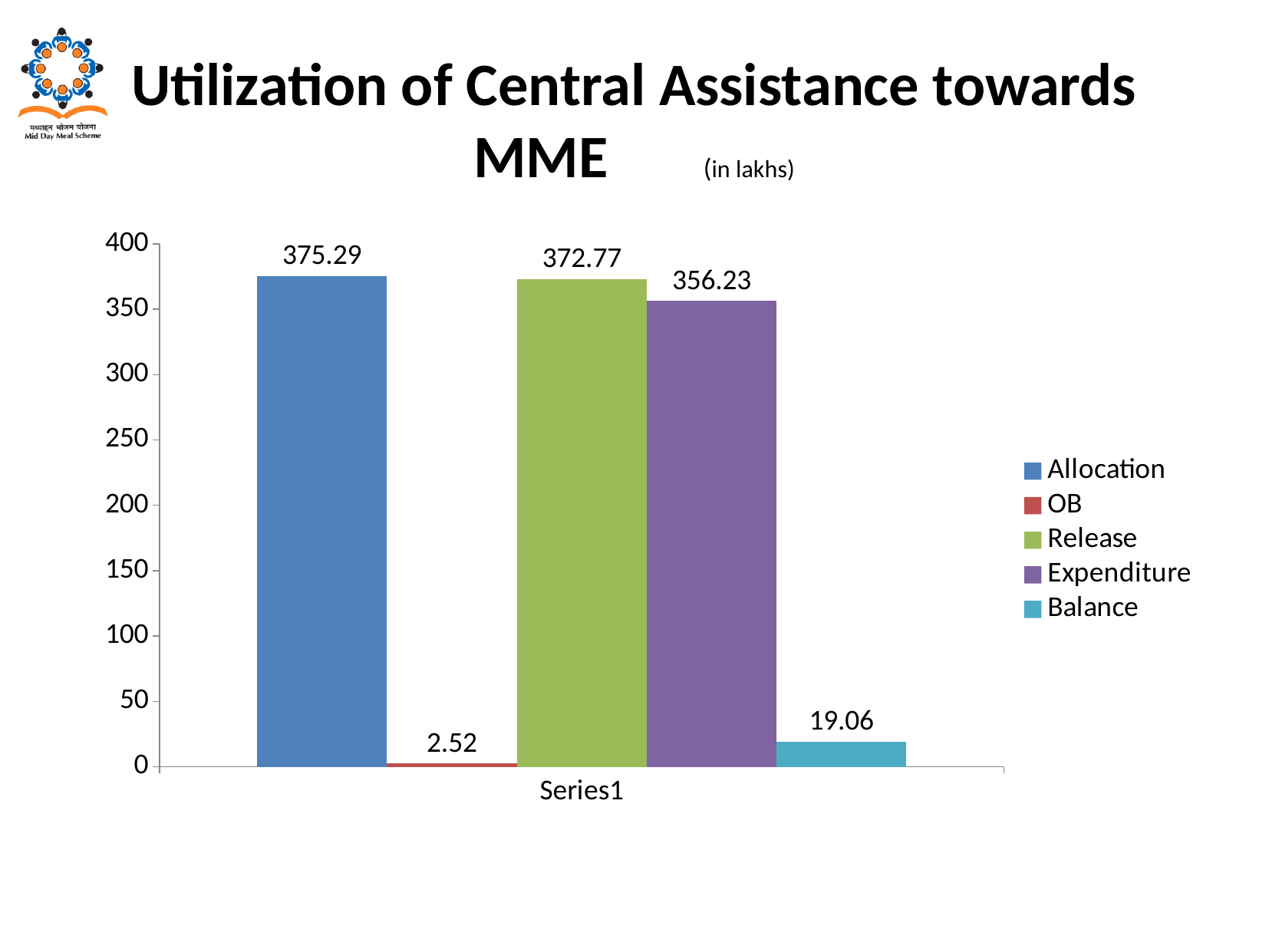
What is the difference between Release and Expenditure? 16.54 Is the value for Expenditure greater or less than 350? greater Which series has the lowest value? OB Which series has the highest value? Allocation What is the value for Release? 372.77 Which is larger, Expenditure or Balance? Expenditure What is the value for OB? 2.52 How many series does the legend list? 5 What is the value for Allocation? 375.29 What is the value for Balance? 19.06 What is the value for Expenditure? 356.23 What kind of chart is shown on the slide? bar chart